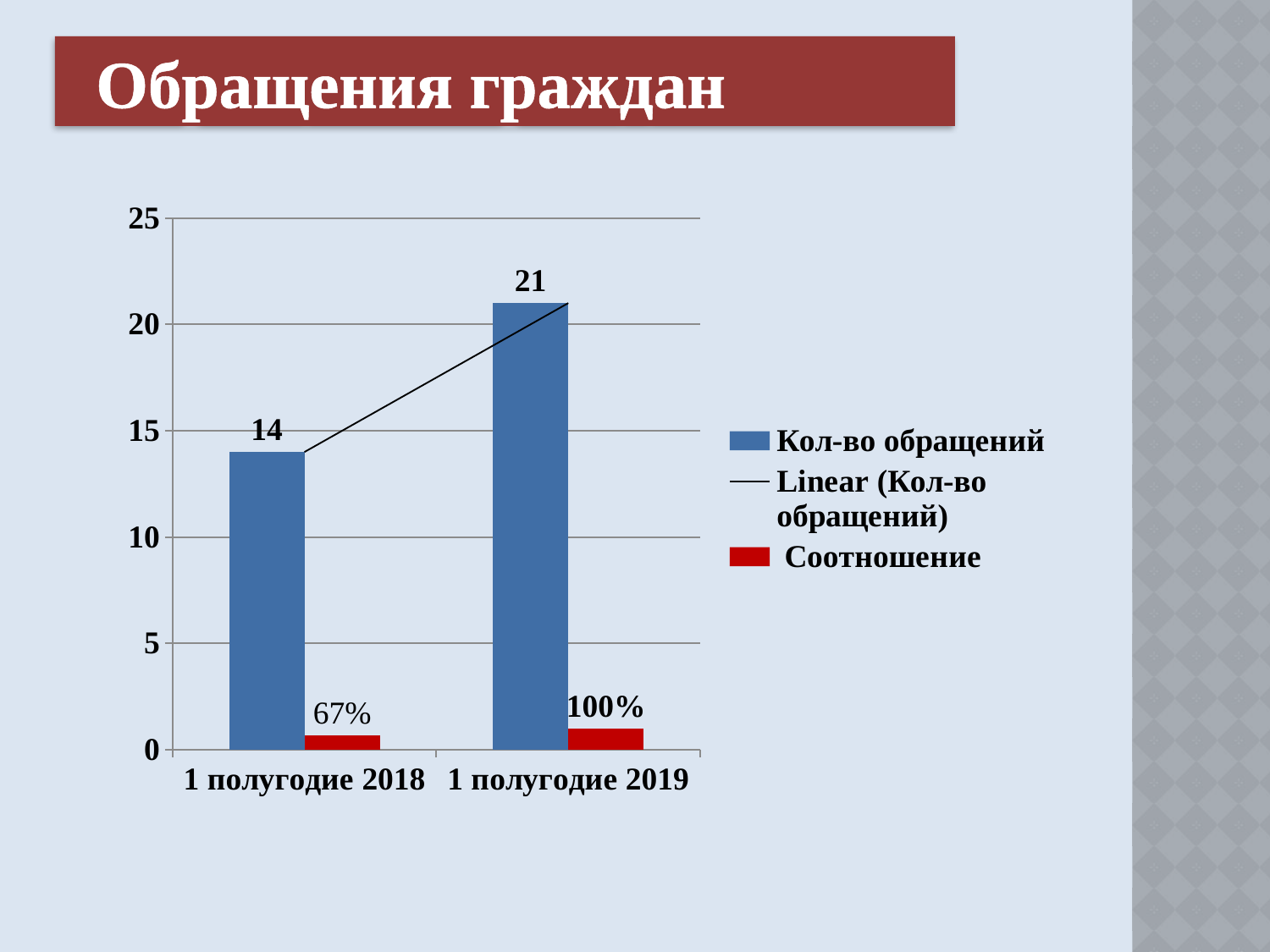
How many entries does the legend list? 3 What is the value of Кол-во обращений for 1 полугодие 2018? 14 What is the Соотношение value shown for 1 полугодие 2018? 67% What kind of chart is shown on the slide? Bar chart How many categories are shown on the x axis? 2 What is the Соотношение value shown for 1 полугодие 2019? 100% What is the value of Кол-во обращений for 1 полугодие 2019? 21 Which period has the lower number of Кол-во обращений? 1 полугодие 2018 Does the number of Кол-во обращений rise or fall from 1 полугодие 2018 to 1 полугодие 2019? Rise Which period has the higher number of Кол-во обращений? 1 полугодие 2019 Is the Кол-во обращений value for 1 полугодие 2019 greater or less than 20? greater By how much did Кол-во обращений increase from 1 полугодие 2018 to 1 полугодие 2019? 7